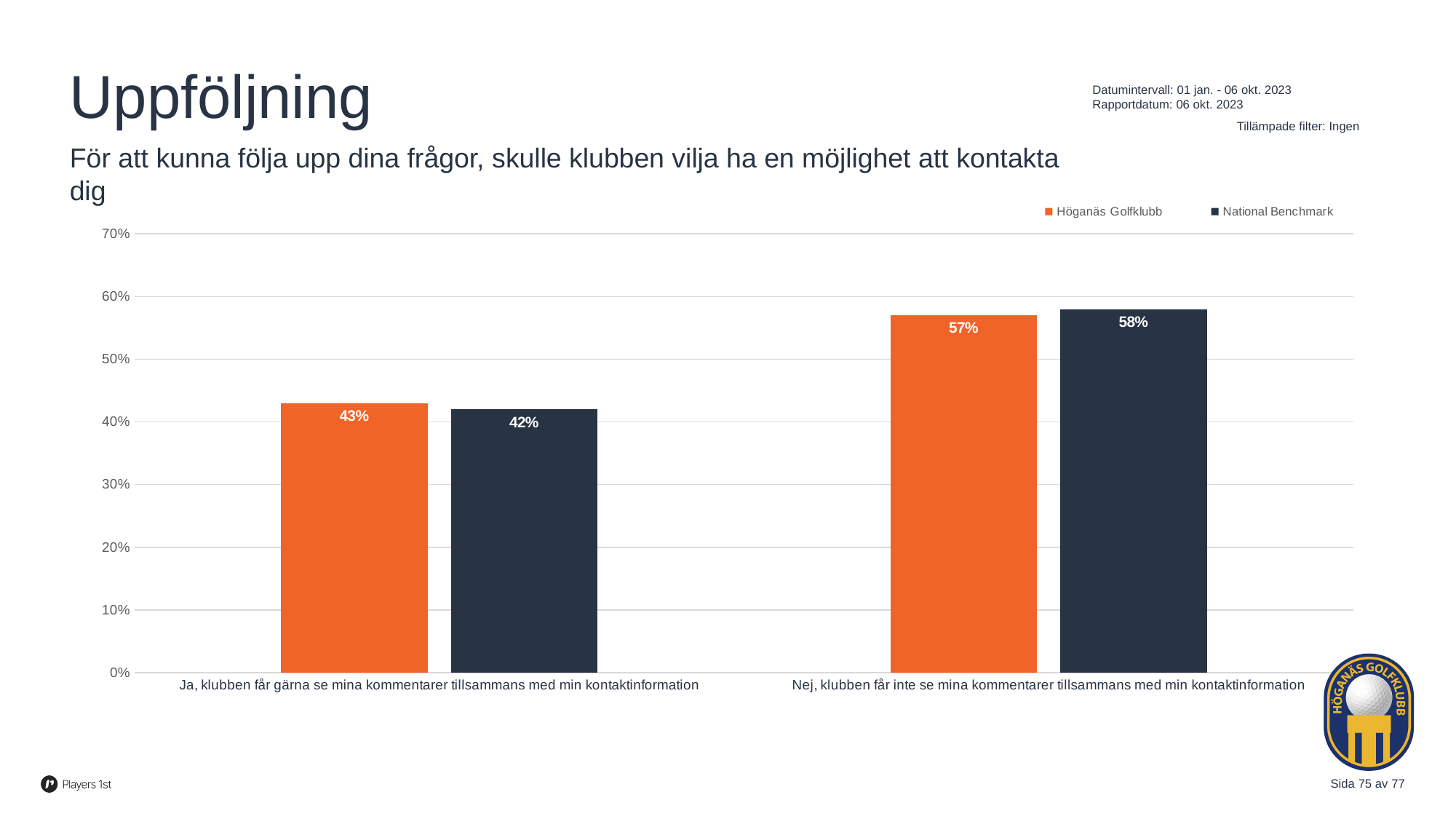
What is the value for National Benchmark for "Ja, klubben får gärna se mina kommentarer tillsammans med min kontaktinformation"? 42% Which colour represents Höganäs Golfklubb in the chart? Orange What is the value for National Benchmark for "Nej, klubben får inte se mina kommentarer tillsammans med min kontaktinformation"? 58% What is the difference between the Höganäs Golfklubb values for the "Nej" and "Ja" categories? 14 percentage points How many series does the legend list? 2 What is the value for Höganäs Golfklubb for "Nej, klubben får inte se mina kommentarer tillsammans med min kontaktinformation"? 57% What is the value for Höganäs Golfklubb for "Ja, klubben får gärna se mina kommentarer tillsammans med min kontaktinformation"? 43% What is the difference between the National Benchmark and Höganäs Golfklubb values for the "Nej" category? 1 percentage point What kind of chart is shown on the slide? Bar chart How many categories are shown on the x axis? 2 Which category has the highest value for Höganäs Golfklubb? Nej, klubben får inte se mina kommentarer tillsammans med min kontaktinformation Which category has the lowest value for National Benchmark? Ja, klubben får gärna se mina kommentarer tillsammans med min kontaktinformation